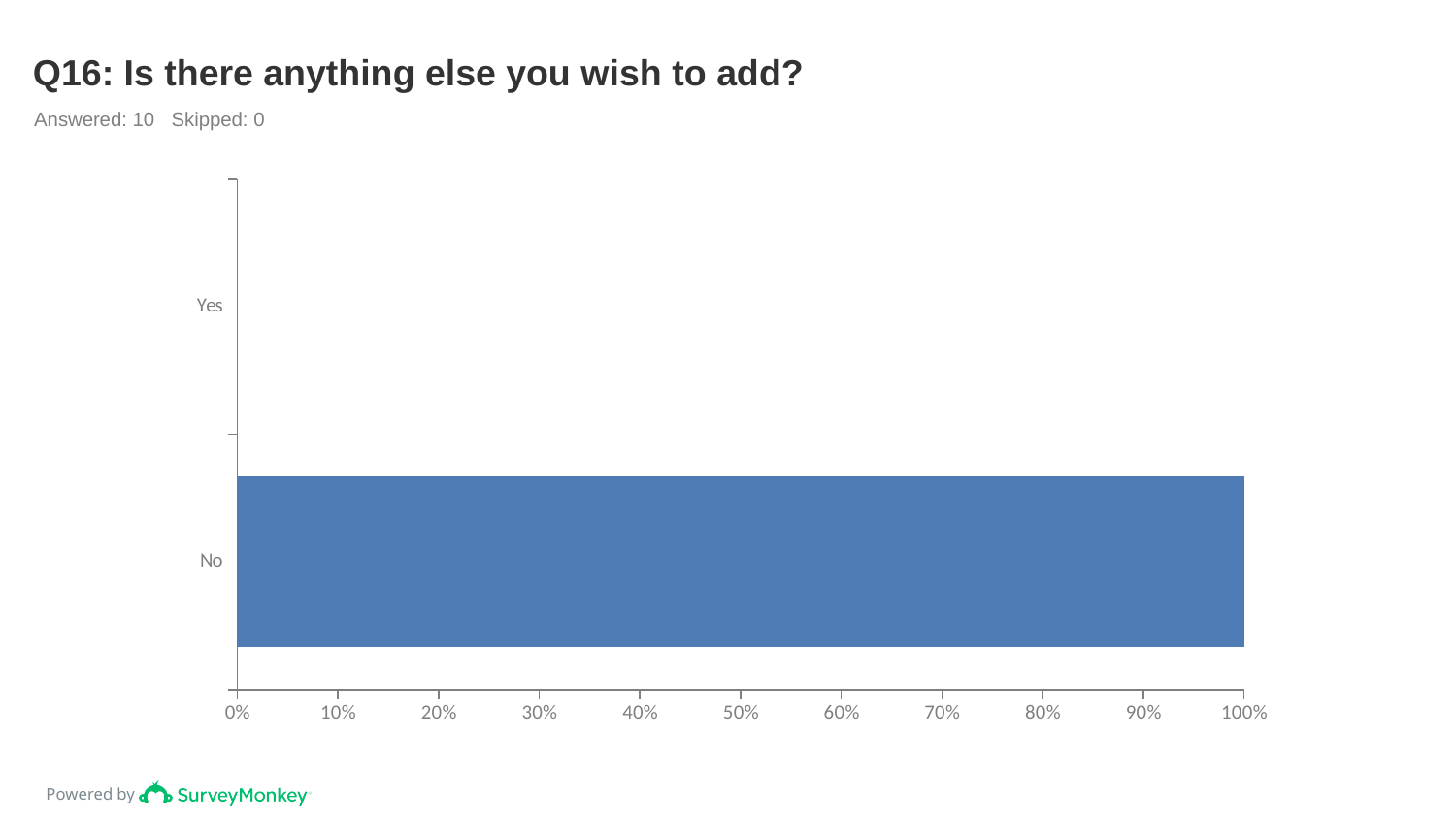
Which is larger, the value for Yes or the value for No? No What is the difference between the values for No and Yes? 100% How many categories are shown on the chart? 2 How many respondents answered the question according to the slide? 10 Which category has the lowest value? Yes Which category has the highest value? No What is the value for No? 100% What is the title of the chart? Q16: Is there anything else you wish to add? What kind of chart is shown on the slide? bar chart Is the value for Yes greater or less than 10%? less Is the value for No greater or less than 50%? greater What is the value for Yes? 0%